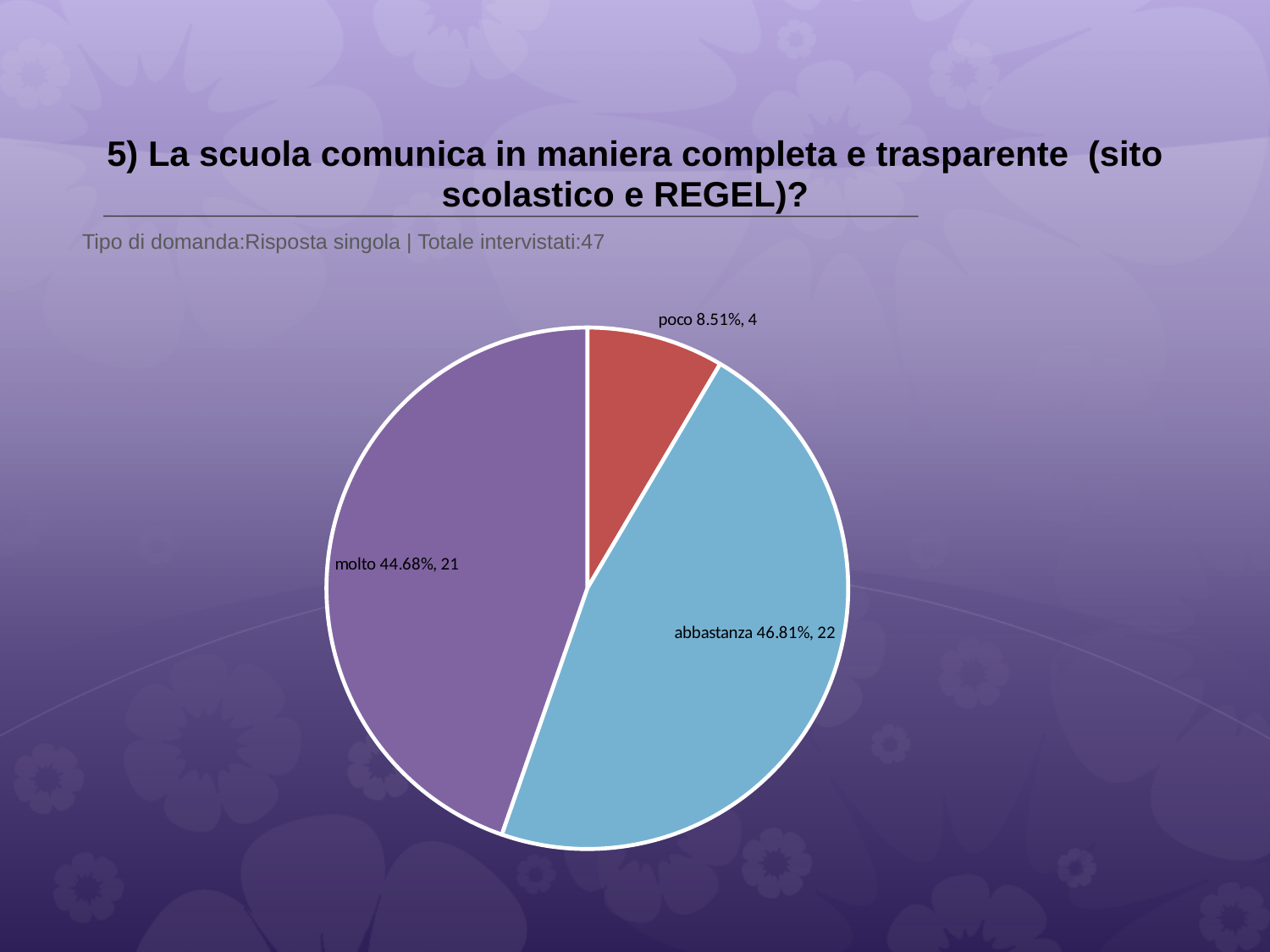
Which response has more respondents, "molto" or "abbastanza"? abbastanza What is the difference in the number of respondents between "abbastanza" and "poco"? 18 What colour is the "molto" slice of the pie chart? purple How many respondents answered "poco"? 4 What kind of chart is shown on the slide? pie chart Which response has the smallest share of the pie? poco What percentage of respondents answered "poco"? 8.51% How many respondents answered "abbastanza"? 22 Which response has the largest share of the pie? abbastanza How many slices does the pie chart have? 3 What percentage of respondents answered "molto"? 44.68% What is the total number of respondents shown in the pie chart? 47